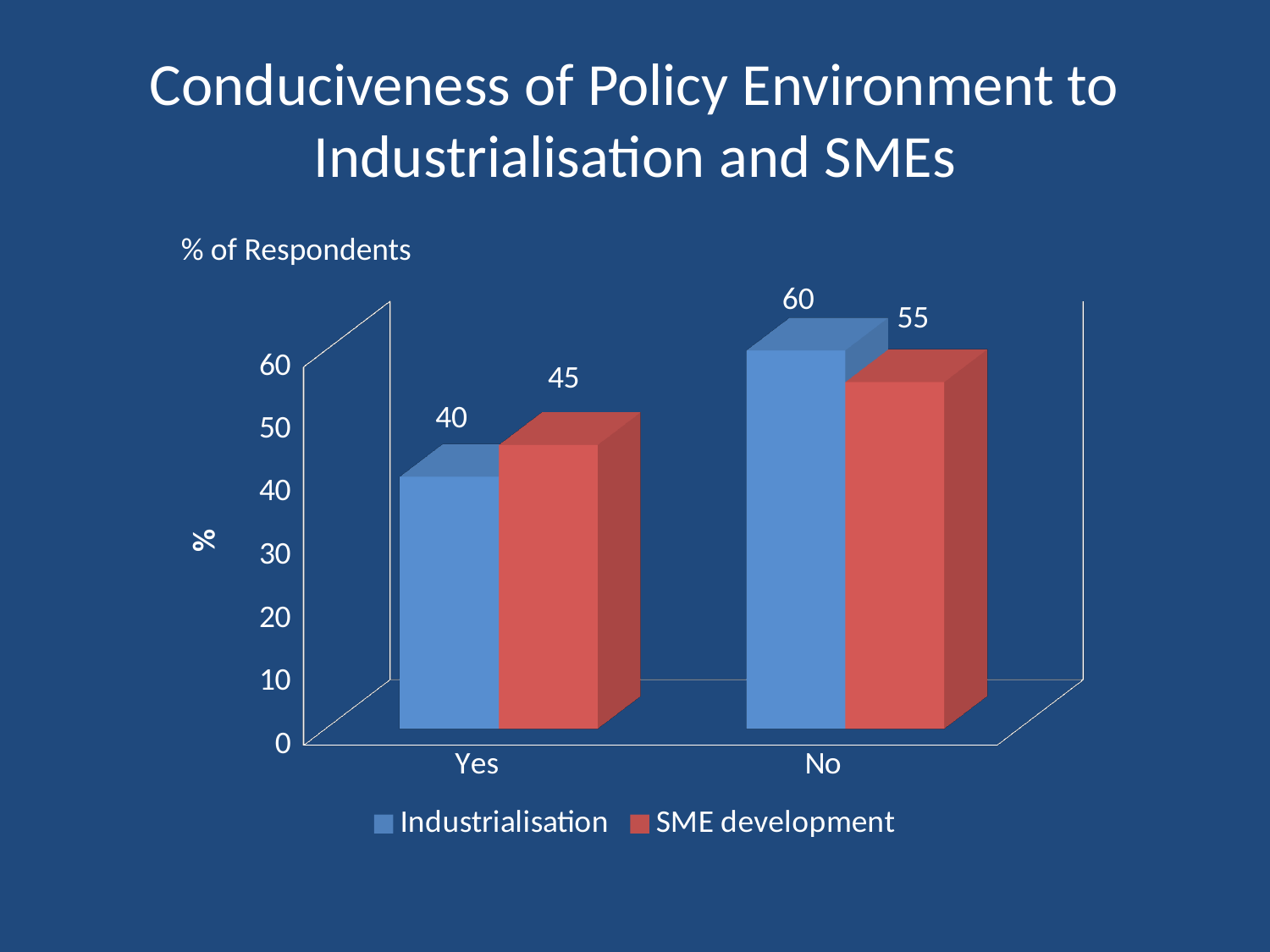
What is the value for Industrialisation in the Yes category? 40 How many series does the legend list? 2 Which category has the highest value for Industrialisation? No Which is larger in the Yes category: Industrialisation or SME development? SME development Which category has the lowest value for SME development? Yes What is the value for SME development in the Yes category? 45 What is the value for Industrialisation in the No category? 60 What kind of chart is shown on the slide? Bar chart What is the difference between the Industrialisation and SME development values in the No category? 5 What is the value for SME development in the No category? 55 How many categories are shown on the x axis? 2 What is the title of the chart? % of Respondents